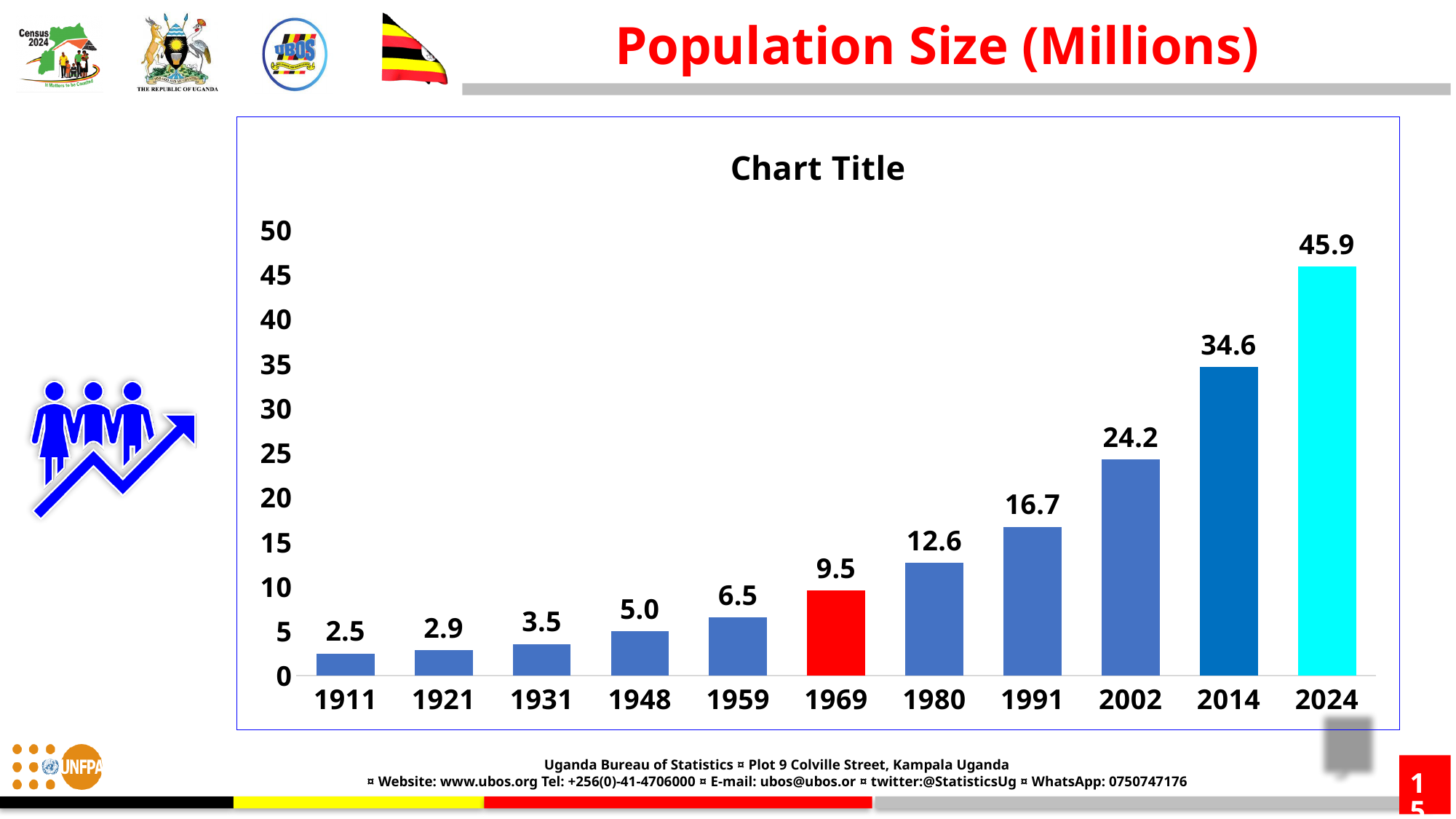
Which is larger, the population size in 1980 or in 1959? 1980 Is the value for 2014 greater or less than 30? greater What is the difference between the population size in 2024 and in 2014? 11.3 Which year has the highest population size? 2024 Which year has the lowest population size? 1911 How many years are shown on the x axis? 11 What is the difference between the population size in 2002 and in 1991? 7.5 What kind of chart is shown on the slide? bar chart What is the population size shown for 2024? 45.9 What is the population size shown for 1948? 5.0 Do the values rise or fall from 1911 to 2024? rise What is the population size shown for 1969? 9.5